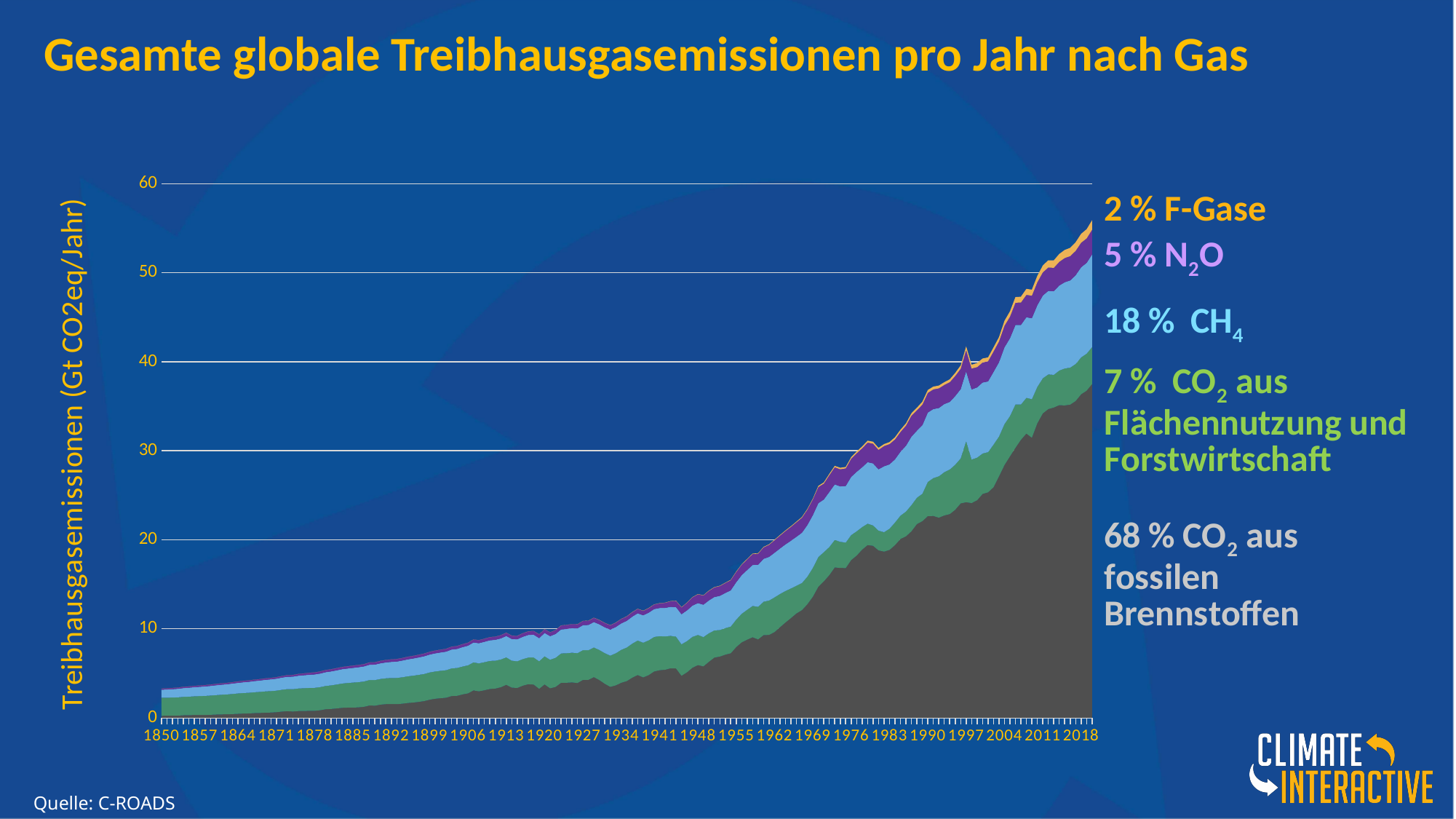
What share of emissions is attributed to CH4? 18 % What is the title of the chart? Gesamte globale Treibhausgasemissionen pro Jahr nach Gas Which has a larger share, CH4 or N2O? CH4 Which gas category has the smallest share of emissions? F-Gase Do total emissions rise or fall from 1850 to 2018? Rise How many gas categories are labelled on the chart? 5 What share of emissions is attributed to CO2 aus Flächennutzung und Forstwirtschaft? 7 % What kind of chart is shown on the slide? Stacked area chart Which gas category has the largest share of emissions? CO2 aus fossilen Brennstoffen Is the total emissions value at the end of the series (around 2018) greater or less than 50 Gt CO2eq/Jahr? greater What share of emissions is attributed to CO2 aus fossilen Brennstoffen? 68 % What share of emissions is attributed to N2O? 5 %